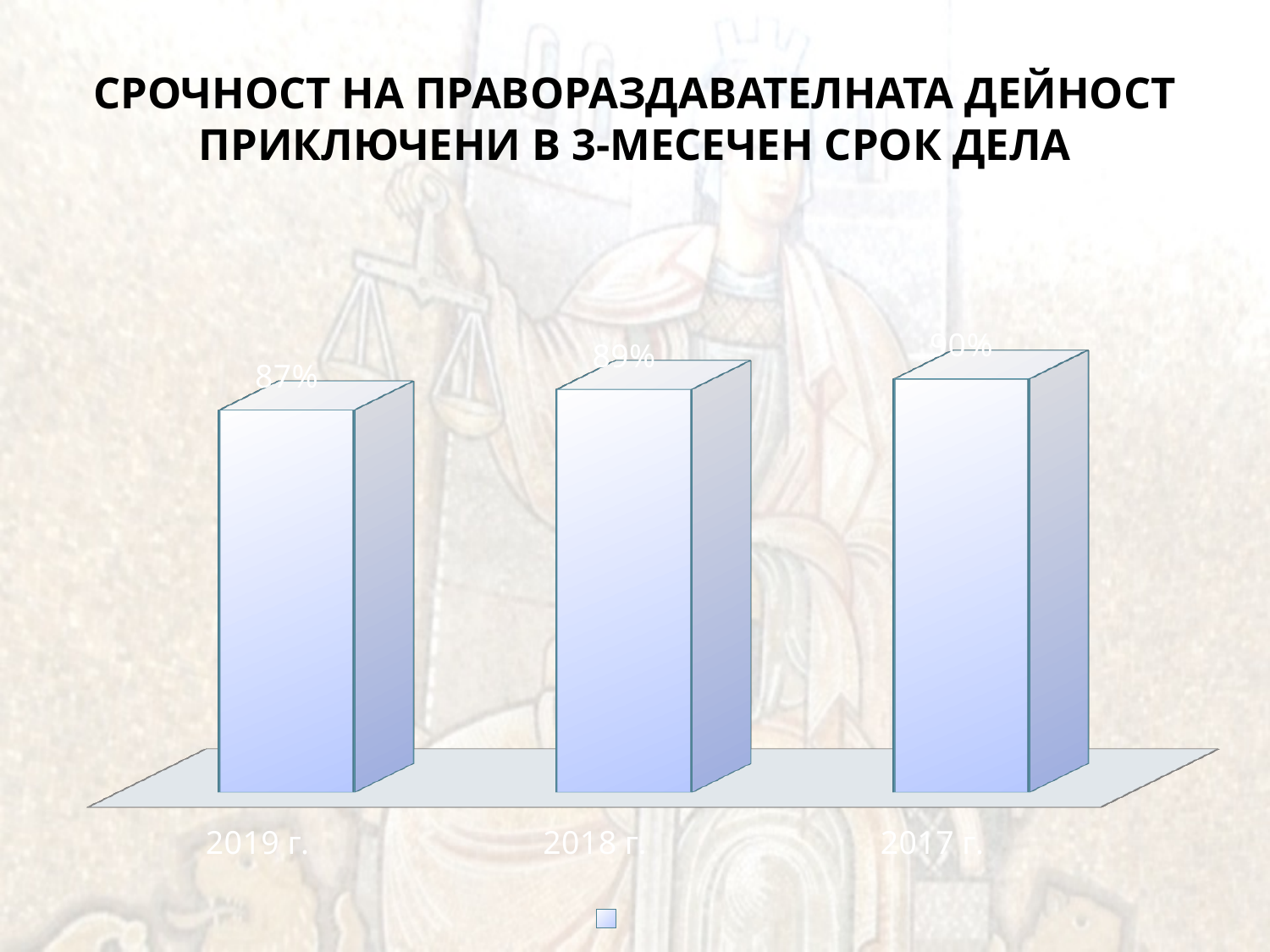
Do the values rise or fall along the x axis from 2019 г. to 2017 г.? Rise Which year has the lowest value? 2019 г. What kind of chart is shown on the slide? Bar chart What is the value for 2019 г.? 87% What is the value for 2017 г.? 90% What is the difference between the values for 2017 г. and 2019 г.? 3% Which year has the highest value? 2017 г. How many categories are shown on the chart? 3 What is the difference between the values for 2018 г. and 2019 г.? 2% What is the title of the chart? СРОЧНОСТ НА ПРАВОРАЗДАВАТЕЛНАТА ДЕЙНОСТ ПРИКЛЮЧЕНИ В 3-МЕСЕЧЕН СРОК ДЕЛА Which is larger, the value for 2018 г. or the value for 2019 г.? 2018 г. What is the value for 2018 г.? 89%